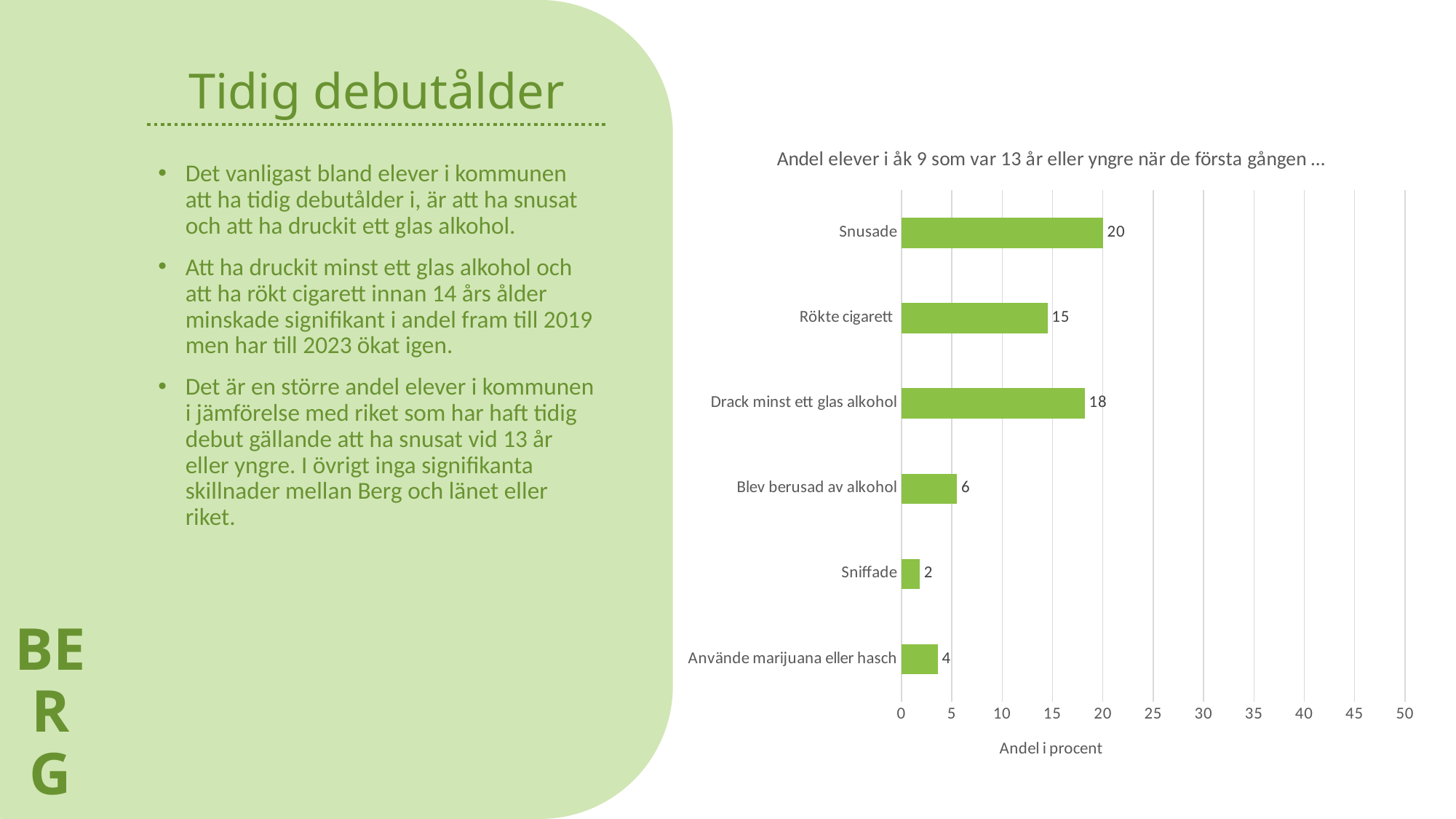
What is the value for Använde marijuana eller hasch? 4 What kind of chart is shown on the slide? bar chart What is the value for Snusade? 20 What is the value for Rökte cigarett? 15 What is the label of the horizontal axis? Andel i procent Which category has the lowest value? Sniffade How many categories are shown in the chart? 6 Is the value for Blev berusad av alkohol greater or less than 10? less Which is larger, the value for Rökte cigarett or the value for Drack minst ett glas alkohol? Drack minst ett glas alkohol What is the difference between the values for Snusade and Drack minst ett glas alkohol? 2 Which category has the highest value? Snusade What is the value for Blev berusad av alkohol? 6